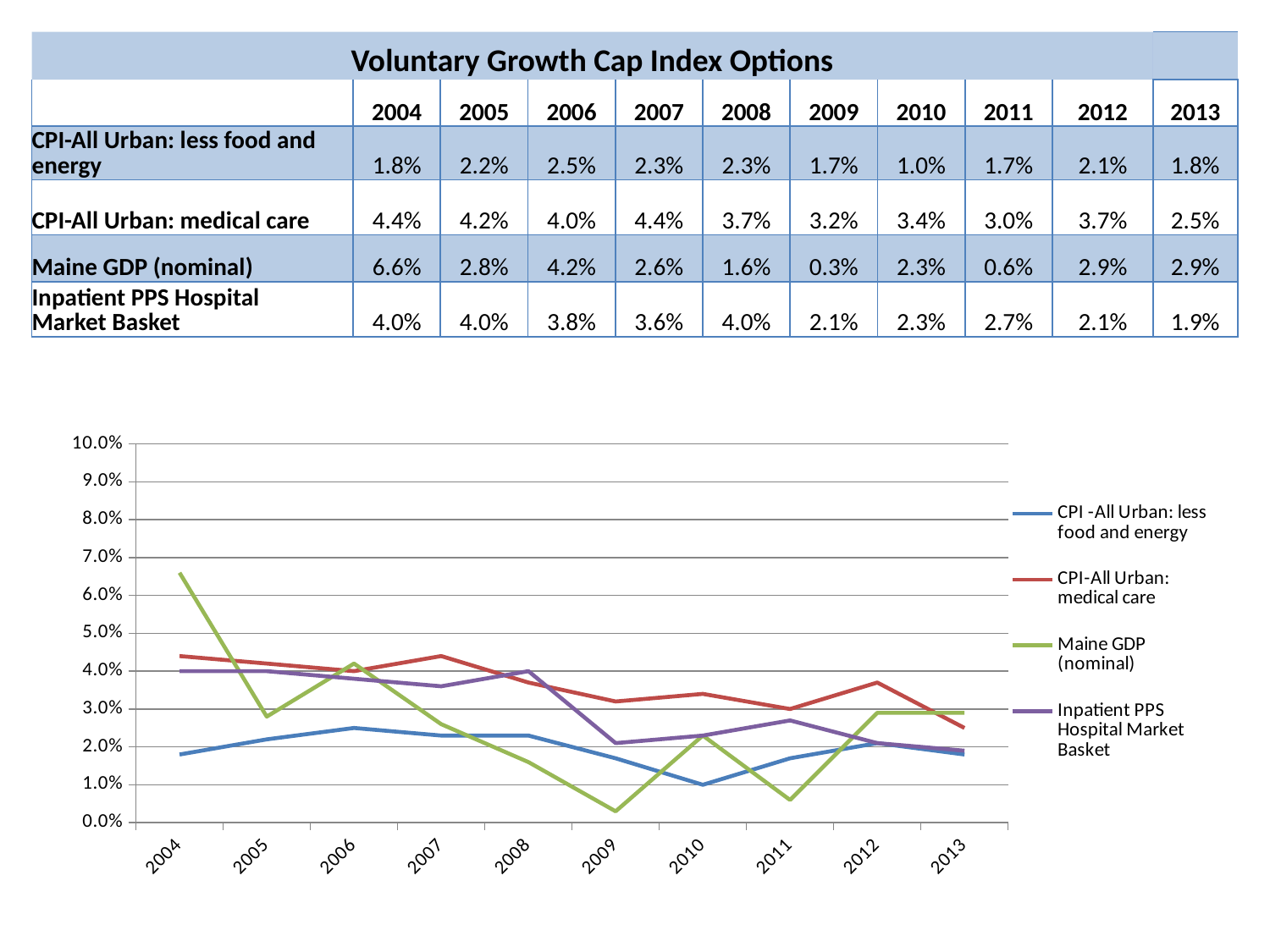
Is the value for Maine GDP (nominal) in 2004 greater or less than 6.0%? greater What is the value for Maine GDP (nominal) in 2004? 6.6% How many years are plotted along the x axis of the chart? 10 What is the value for CPI-All Urban: medical care in 2007? 4.4% In which year is CPI-All Urban: less food and energy highest? 2006 What is the value for Inpatient PPS Hospital Market Basket in 2011? 2.7% Which is larger in 2008: Inpatient PPS Hospital Market Basket or CPI-All Urban: medical care? Inpatient PPS Hospital Market Basket How many series does the chart's legend list? 4 What is the difference between CPI-All Urban: medical care and CPI-All Urban: less food and energy in 2010? 2.4% In which year is Maine GDP (nominal) lowest? 2009 What kind of chart is shown on the slide? line chart Does the CPI-All Urban: medical care line generally rise or fall from 2004 to 2013? fall